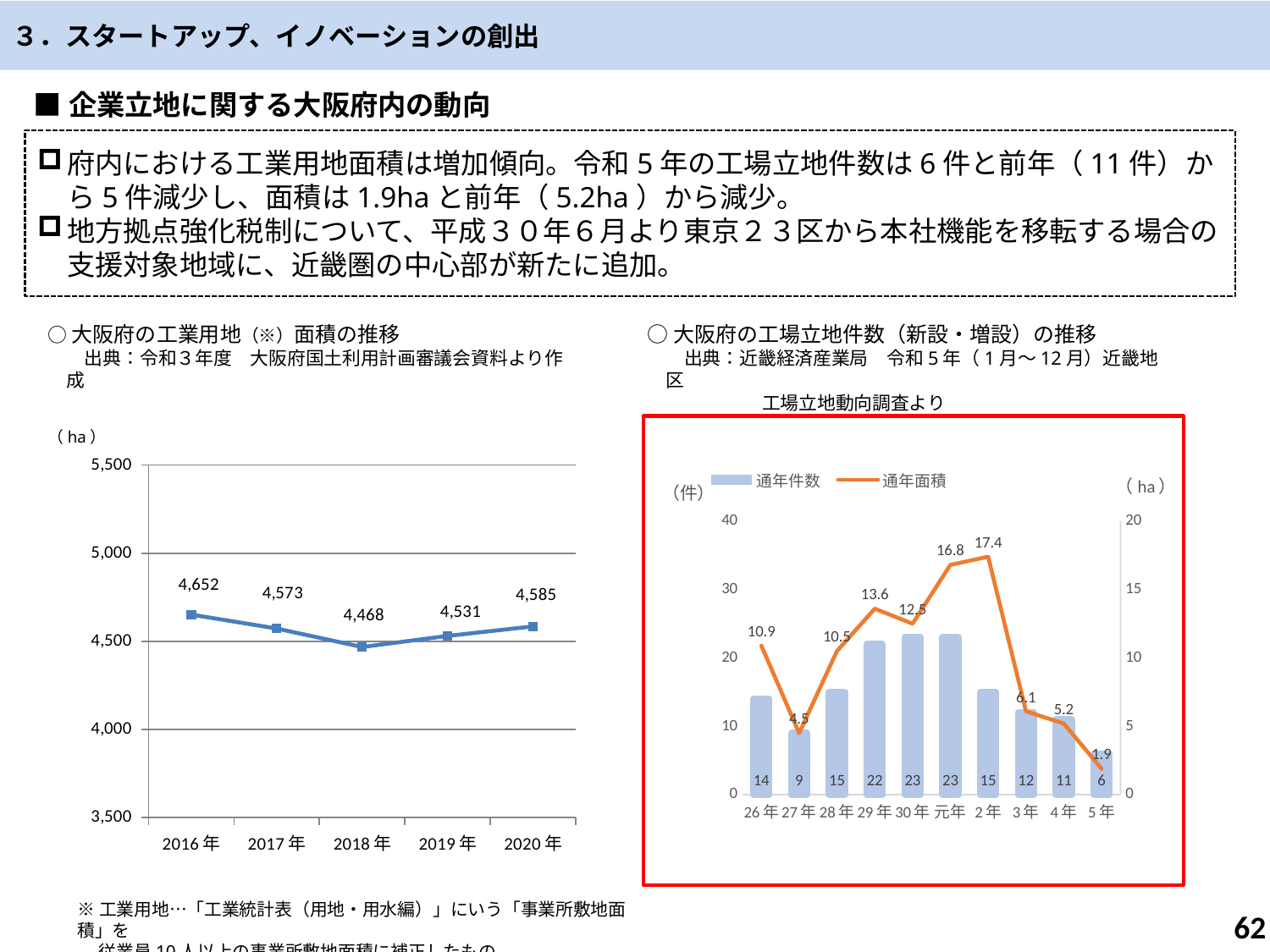
In the right chart (大阪府の工場立地件数の推移), what is the 通年面積 value for 元年? 16.8 In the left chart (大阪府の工業用地面積の推移), how many data points are plotted? 5 In the right chart (大阪府の工場立地件数の推移), what is the 通年件数 value for 29年? 22 In the right chart (大阪府の工場立地件数の推移), which year has the highest 通年面積 value? 2年 How many series does the legend of the right chart (大阪府の工場立地件数の推移) list? 2 In the right chart (大阪府の工場立地件数の推移), which year has the lowest 通年件数 value? 5年 In the left chart (大阪府の工業用地面積の推移), which year has the highest value? 2016年 In the left chart (大阪府の工業用地面積の推移), what is the value for 2018年? 4,468 In the left chart (大阪府の工業用地面積の推移), what is the difference between the 2016年 value and the 2020年 value? 67 In the left chart (大阪府の工業用地面積の推移), which year has the lowest value? 2018年 In the right chart (大阪府の工場立地件数の推移), what is the difference in 通年面積 between 4年 and 5年? 3.3 What kind of chart is the left chart (大阪府の工業用地面積の推移)? Line chart